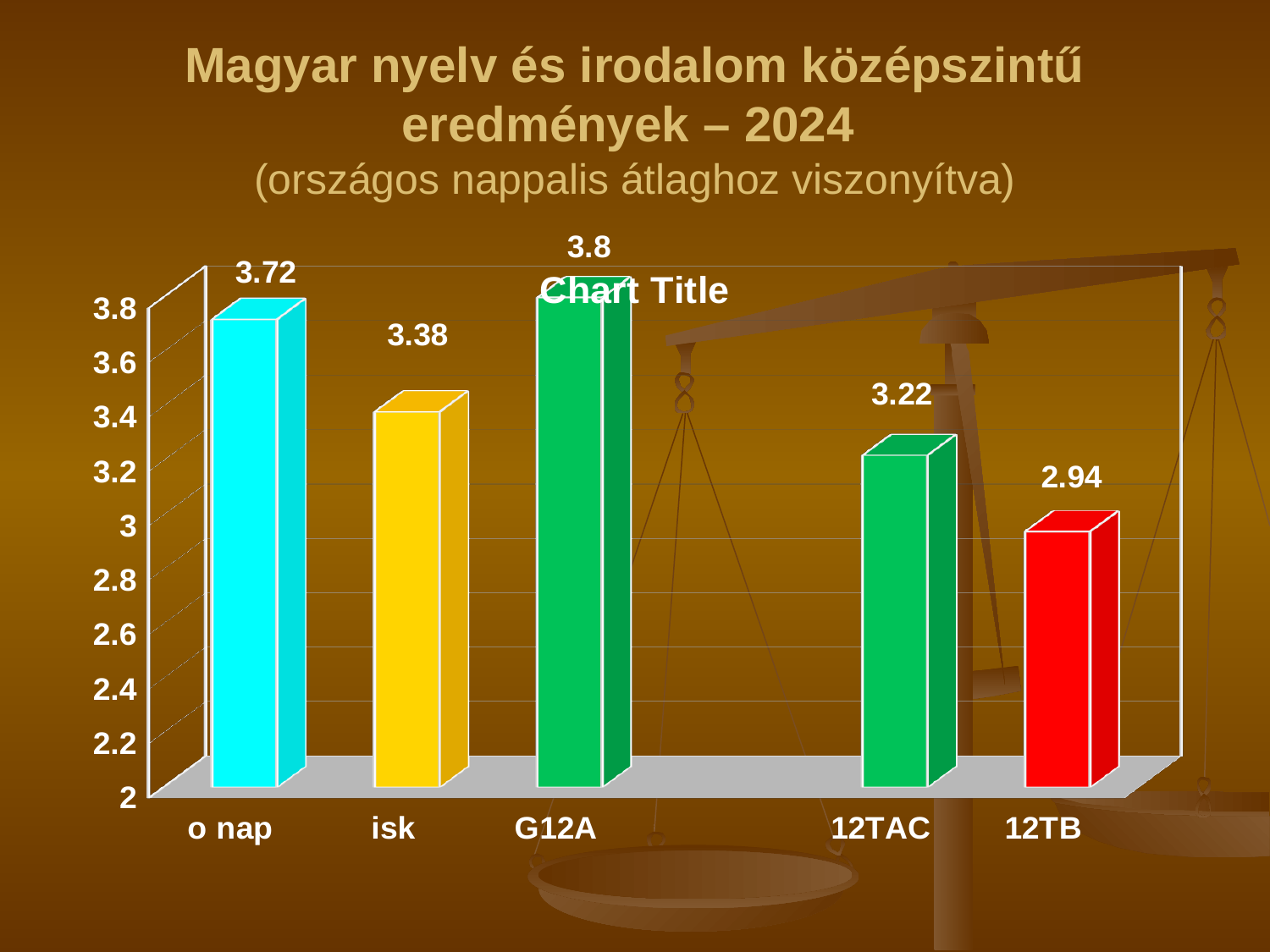
Which category has the highest value? G12A What is the value for o nap? 3.72 How many categories are shown on the x axis? 5 Which category has the lowest value? 12TB Is the value for 12TB greater or less than 3? less What is the value for 12TB? 2.94 What is the value for 12TAC? 3.22 What kind of chart is shown on the slide? bar chart What is the value for isk? 3.38 Which is larger, the value for isk or the value for 12TAC? isk What is the value for G12A? 3.8 What is the difference between the values for o nap and 12TB? 0.78